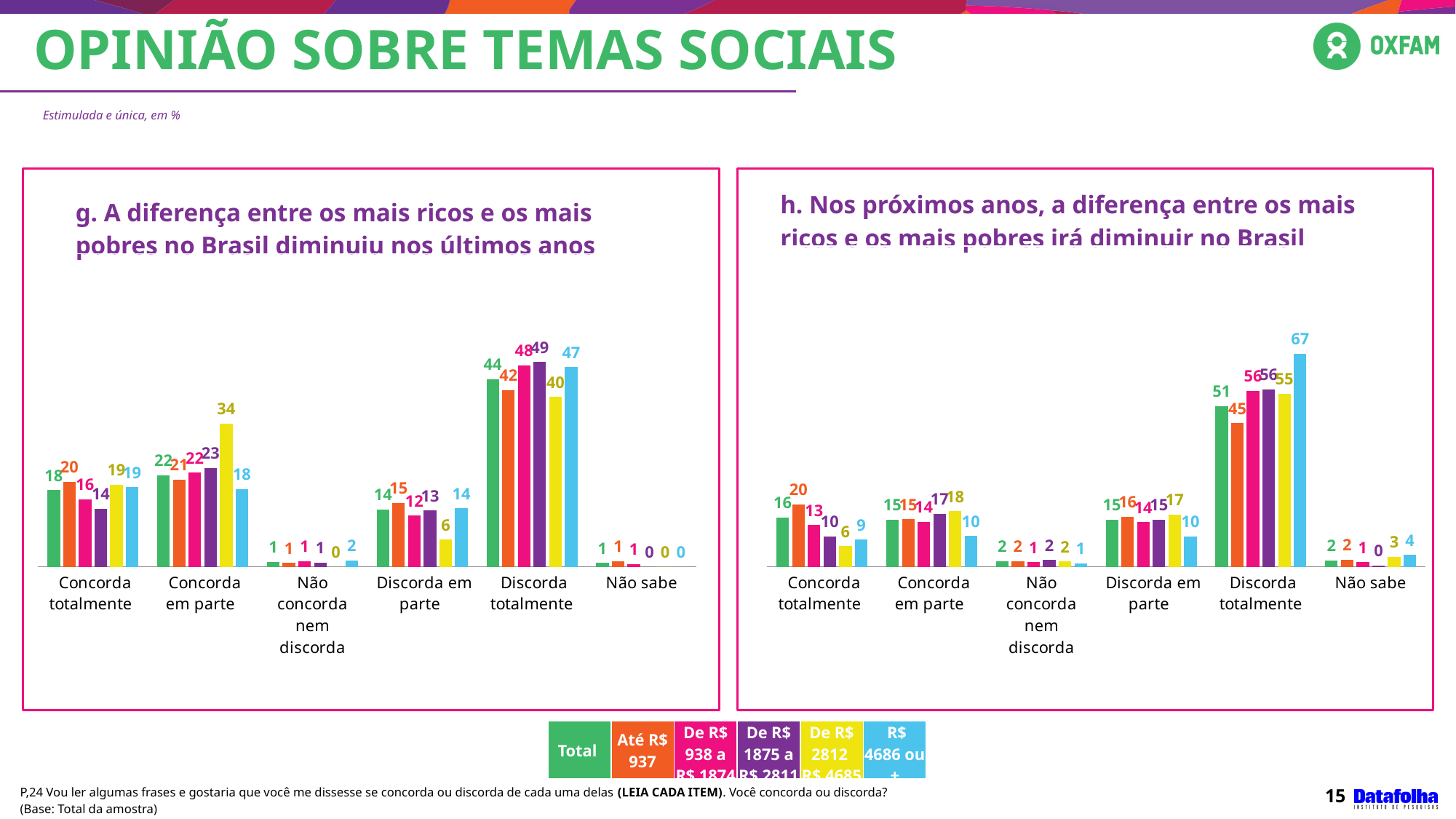
What type of chart is used in the right chart (h.)? Bar chart In the left chart (g. A diferença entre os mais ricos e os mais pobres no Brasil diminuiu nos últimos anos), what is the Total value for 'Discorda totalmente'? 44 In the left chart (g.), for 'Concorda em parte', which is larger: the De R$ 2812 a R$ 4685 value or the R$ 4686 ou + value? De R$ 2812 a R$ 4685 (34) In the left chart (g.), which category has the lowest value for the Até R$ 937 series (orange)? Não concorda nem discorda / Não sabe (both 1) How many response categories are shown on the x axis of the left chart (g.)? 6 In the right chart (h.), which category has the highest Total value? Discorda totalmente In the right chart (h.), what is the Total value for 'Concorda totalmente'? 16 In the right chart (h.), what is the difference between the R$ 4686 ou + value (67) and the Total value (51) for 'Discorda totalmente'? 16 In the left chart (g.), what is the difference between the Total values for 'Discorda totalmente' (44) and 'Concorda totalmente' (18)? 26 How many series does the legend list for the charts? 6 In the right chart (h. Nos próximos anos, a diferença entre os mais ricos e os mais pobres irá diminuir no Brasil), what is the value for 'Discorda totalmente' in the R$ 4686 ou + series (blue)? 67 In the left chart (g.), what is the value for 'Concorda em parte' in the De R$ 2812 a R$ 4685 series (yellow)? 34